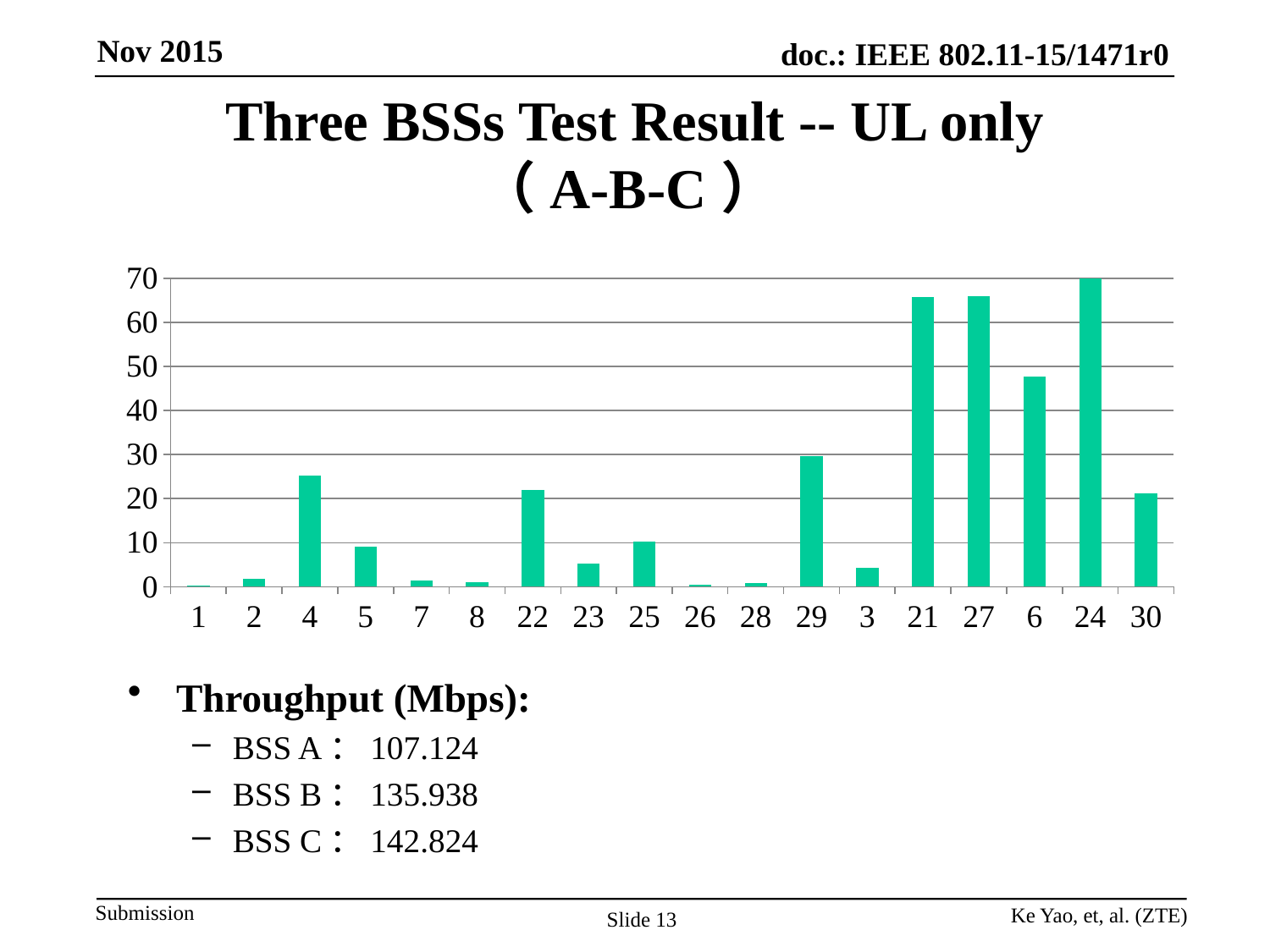
Which category has the highest bar in the chart? 24 What is the title of the chart on the slide? Three BSSs Test Result -- UL only (A-B-C) Which has the larger value, category 6 or category 21? 21 Is the value for category 6 greater or less than 40? greater Which has the larger value, category 5 or category 23? 5 What kind of chart is shown on the slide? bar chart Which has the larger value, category 29 or category 4? 29 Is the value for category 6 greater or less than 50? less Is the value for category 4 greater or less than 20? greater How many categories are plotted along the x axis of the chart? 18